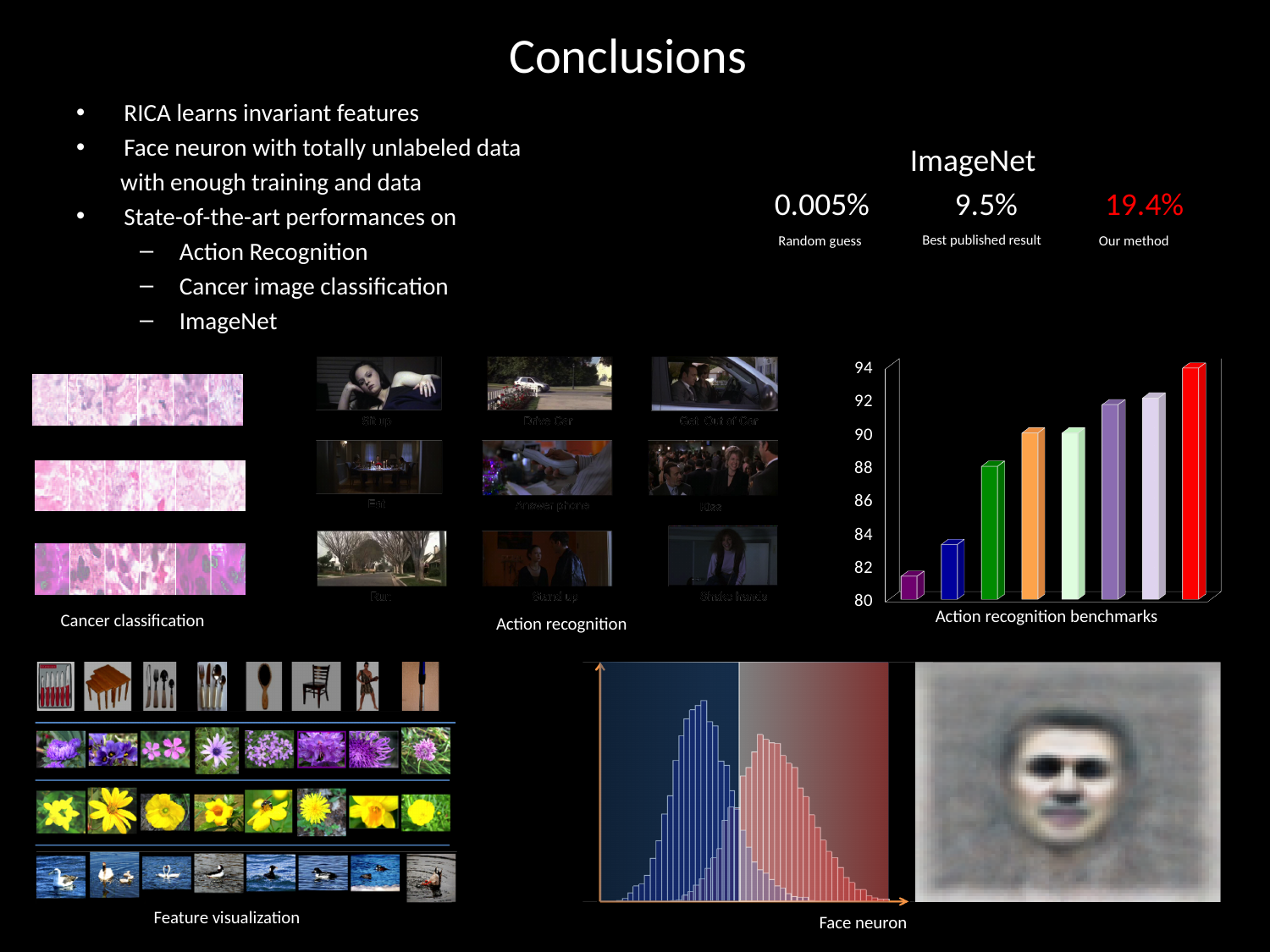
In the 'Action recognition benchmarks' chart, which bar is the highest? the rightmost (red) bar In the 'Action recognition benchmarks' chart, is the value of the green bar greater or less than 86? greater What kind of chart is the 'Action recognition benchmarks' chart? bar chart In the 'Action recognition benchmarks' chart, is the value of the leftmost bar greater or less than 82? less In the 'Action recognition benchmarks' chart, which is larger: the green bar or the orange bar? the orange bar In the 'Action recognition benchmarks' chart, which bar is the lowest? the leftmost (purple) bar What is the lowest value shown on the vertical axis of the 'Action recognition benchmarks' chart? 80 In the 'Action recognition benchmarks' chart, is the value of the second bar from the left (blue) greater or less than 82? greater What is the title shown below the bar chart on the slide? Action recognition benchmarks In the 'Action recognition benchmarks' chart, do the bar values rise or fall from left to right? rise How many bars are plotted in the 'Action recognition benchmarks' chart? 8